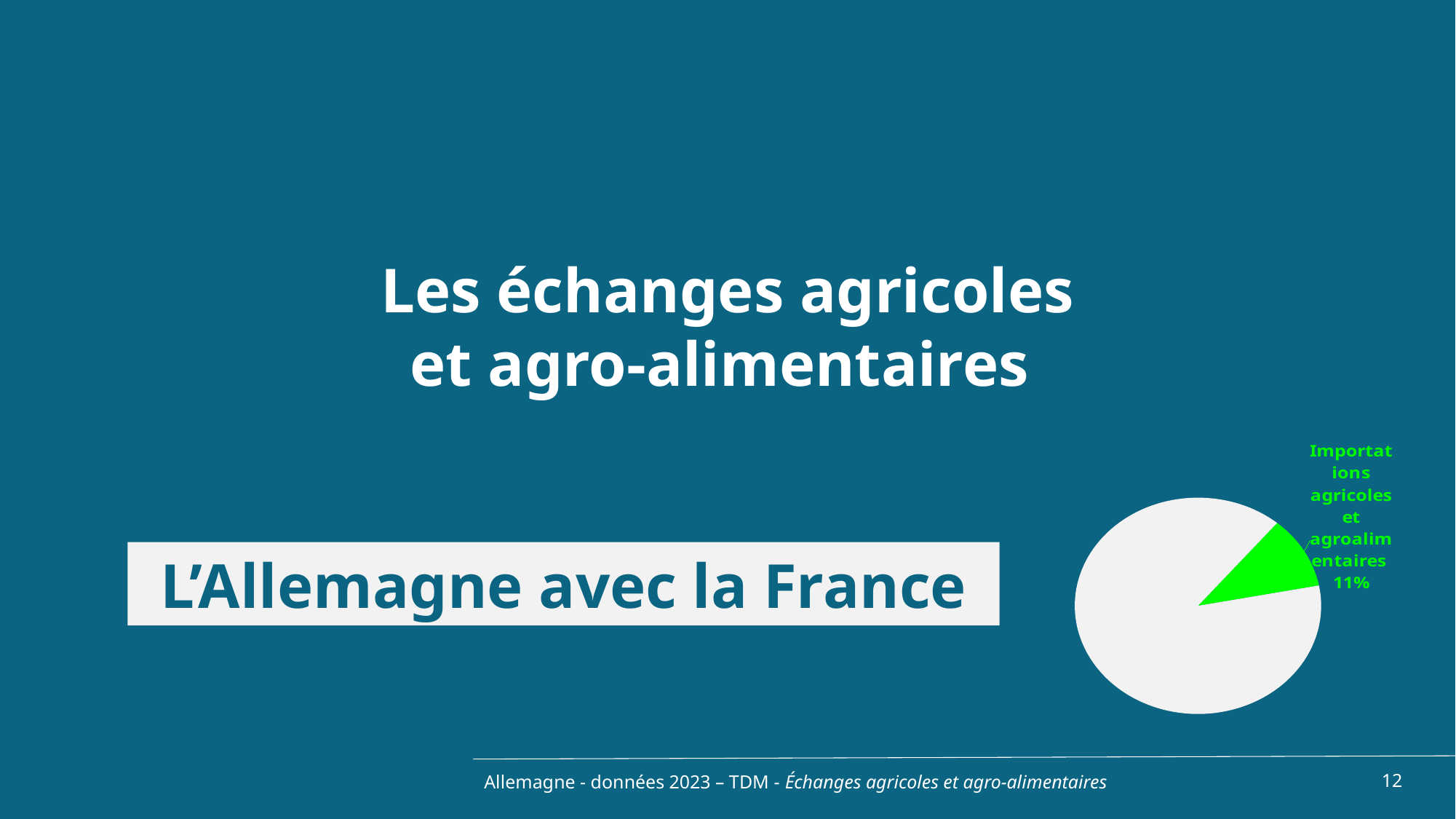
What colour is the slice labelled "Importations agricoles et agroalimentaires"? green What kind of chart is shown on the slide? pie chart Which slice of the pie chart is the smallest? Importations agricoles et agroalimentaires Which slice of the pie chart is larger, the green slice or the white slice? the white slice What share of the pie does the slice labelled "Importations agricoles et agroalimentaires" represent? 11% How many slices does the pie chart have? 2 Is the share of the "Importations agricoles et agroalimentaires" slice greater or less than 50%? less What is the value printed for the green slice of the pie chart? 11%